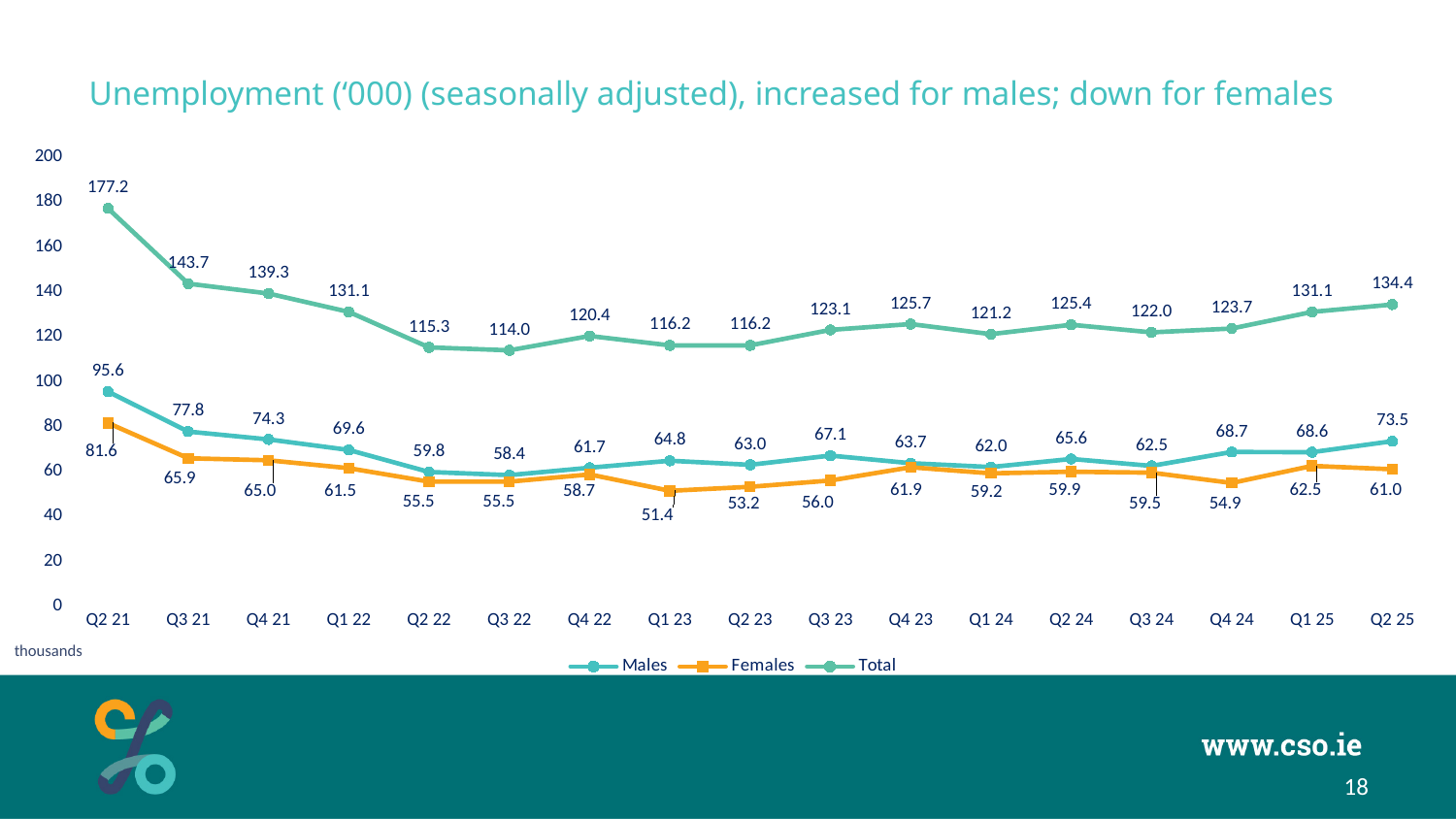
What is the difference between the Males and Females values in Q2 25? 12.5 How many series does the legend list? 3 Does the Total series rise or fall from Q2 21 to Q2 22? Fall In which quarter is the Females series at its lowest? Q1 23 What kind of chart is shown on the slide? Line chart What is the Total unemployment value for Q2 25? 134.4 In which quarter is the Total series at its highest? Q2 21 What is the Males value for Q2 21? 95.6 How many quarters are plotted on the x axis? 17 Which is larger in Q4 23, the Males value or the Females value? Males What is the Females value for Q1 23? 51.4 In which quarter is the Total series at its lowest? Q3 22